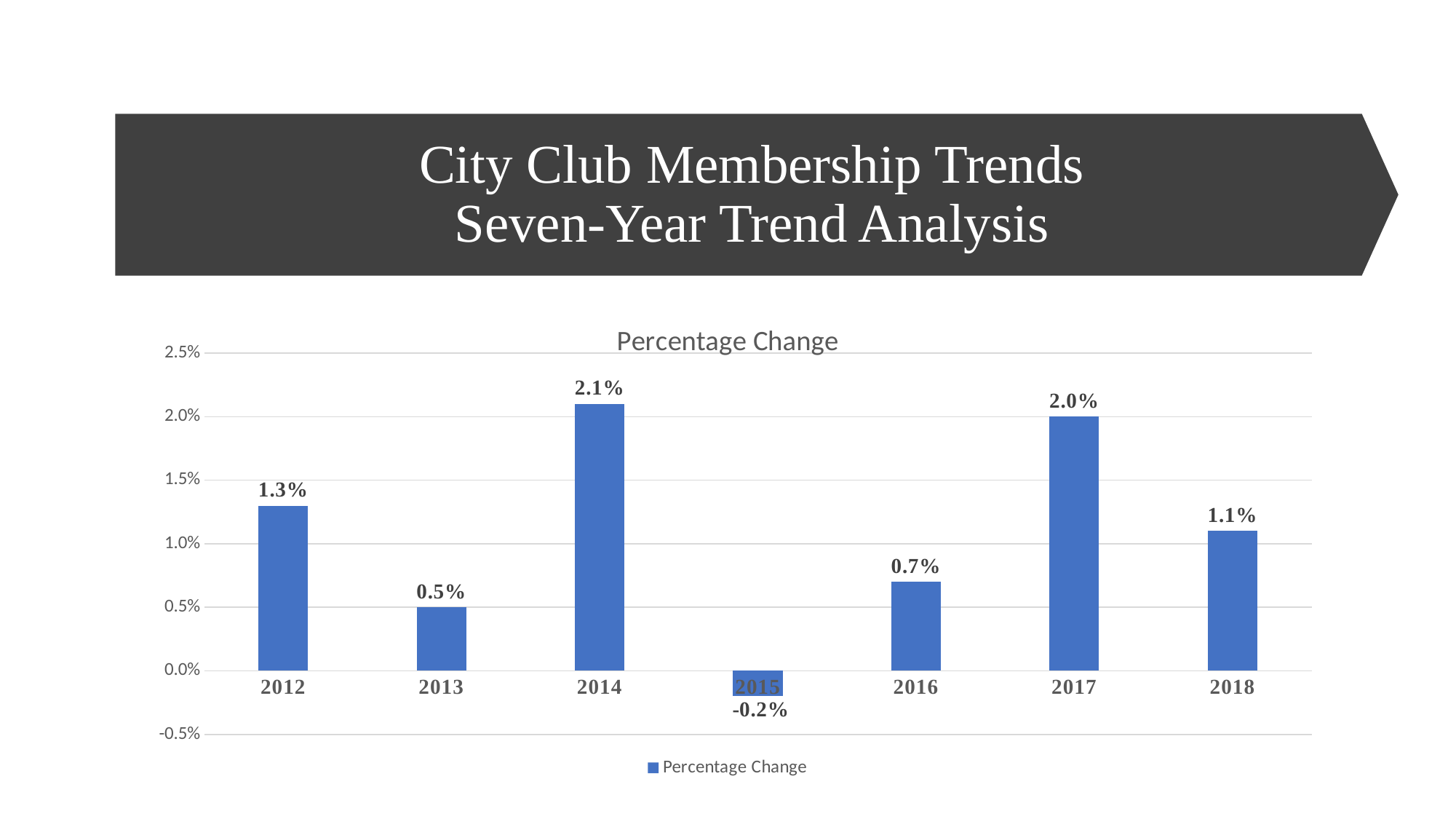
What is the percentage change for 2014? 2.1% How many years are shown on the x axis of the chart? 7 Which year has a larger percentage change, 2012 or 2016? 2012 What kind of chart is shown on the slide? Bar chart What is the title of the chart? Percentage Change Which year has the lowest percentage change? 2015 Which year has the highest percentage change? 2014 What is the percentage change for 2015? -0.2% How many series does the legend list? 1 Is the value for 2017 greater or less than 1.5%? greater What is the percentage change for 2018? 1.1% What is the difference between the percentage change in 2014 and in 2013? 1.6%